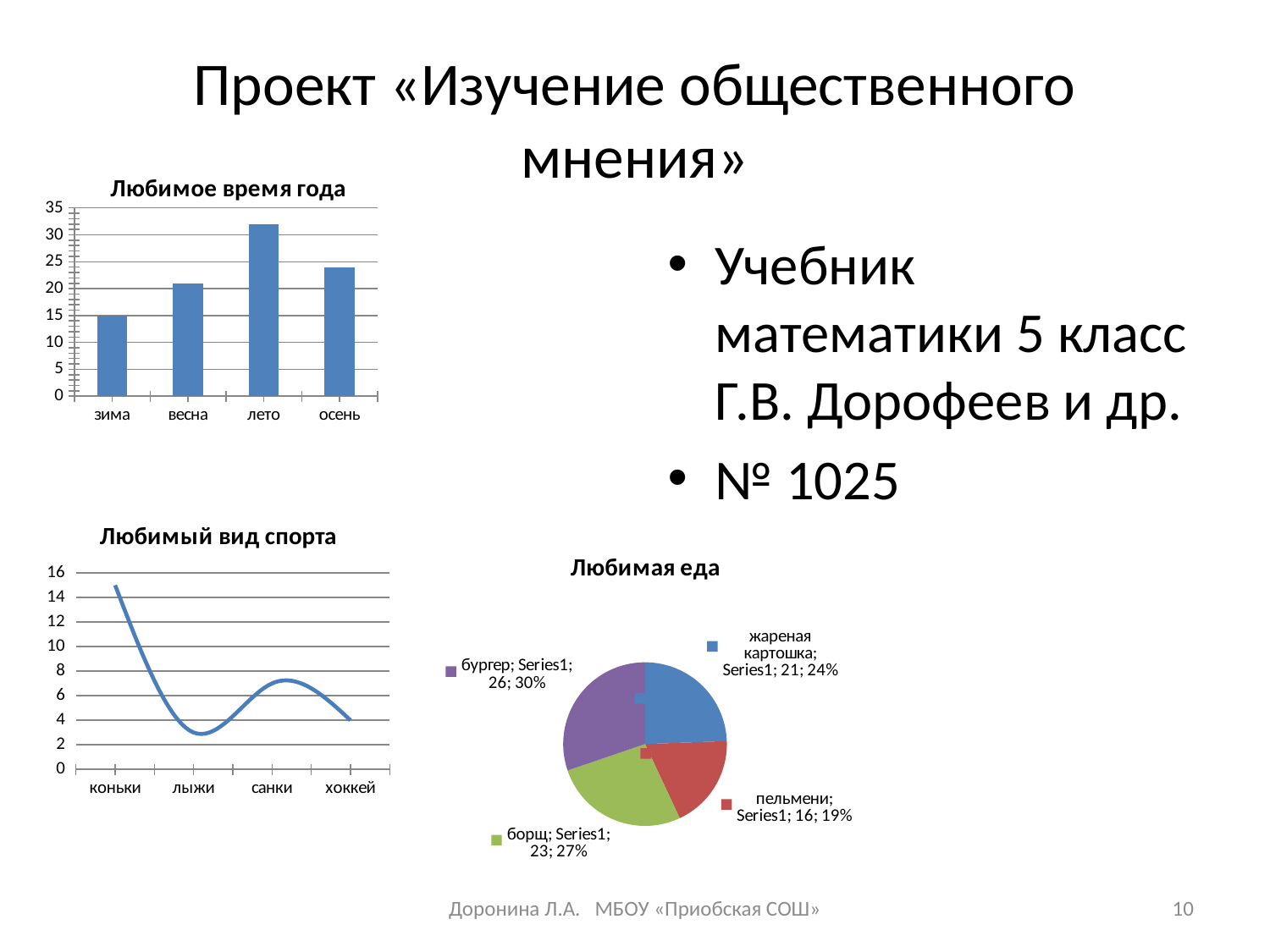
What type of chart is "Любимое время года"? bar chart In the "Любимое время года" chart, is the value for лето greater or less than 30? greater In the "Любимая еда" pie chart, what share does борщ have? 27% In the "Любимое время года" chart, which season has the lowest value? зима In the "Любимое время года" chart, which season has the highest value? лето In the "Любимая еда" pie chart, what is the difference between the values for бургер and жареная картошка? 5 In the "Любимая еда" pie chart, which food has the smallest slice? пельмени In the "Любимое время года" chart, is the value for осень greater or less than 25? less In the "Любимый вид спорта" chart, is the value for лыжи greater or less than 4? less How many categories are shown in the "Любимый вид спорта" chart? 4 In the "Любимый вид спорта" chart, which sport has the highest value? коньки In the "Любимая еда" pie chart, what is the value for бургер? 26